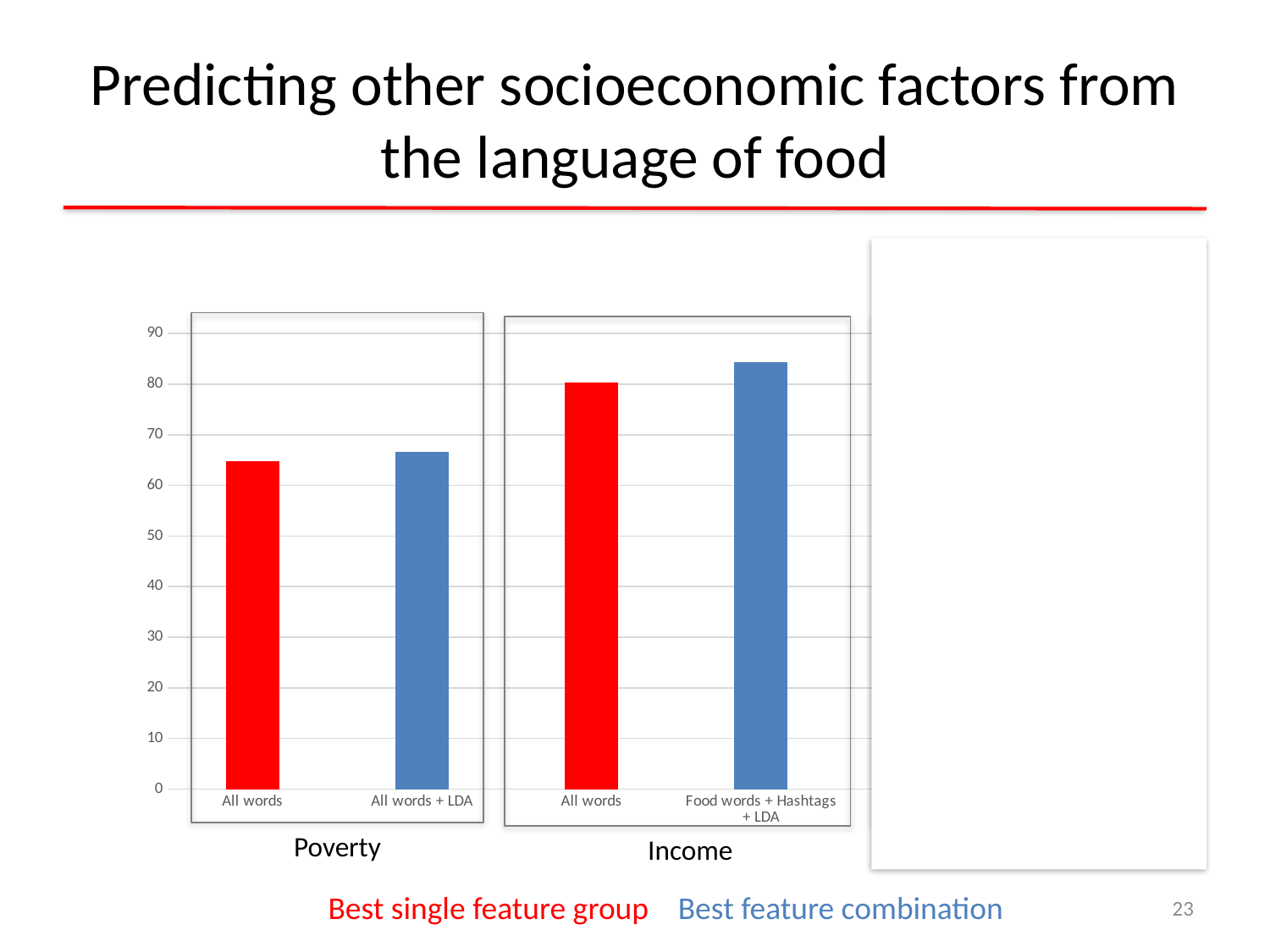
What do the red bars represent according to the legend text below the chart? Best single feature group Is the value for All words + LDA in the Poverty group greater or less than 70? less Is the value for All words in the Poverty group greater or less than 60? greater What kind of chart is shown on the slide? bar chart In the Income group, which is larger: All words or Food words + Hashtags + LDA? Food words + Hashtags + LDA Which group has higher bars overall, Poverty or Income? Income Is the value for All words in the Income group greater or less than 70? greater Which bar has the highest value in the chart? Food words + Hashtags + LDA (Income) How many bars are plotted in the chart? 4